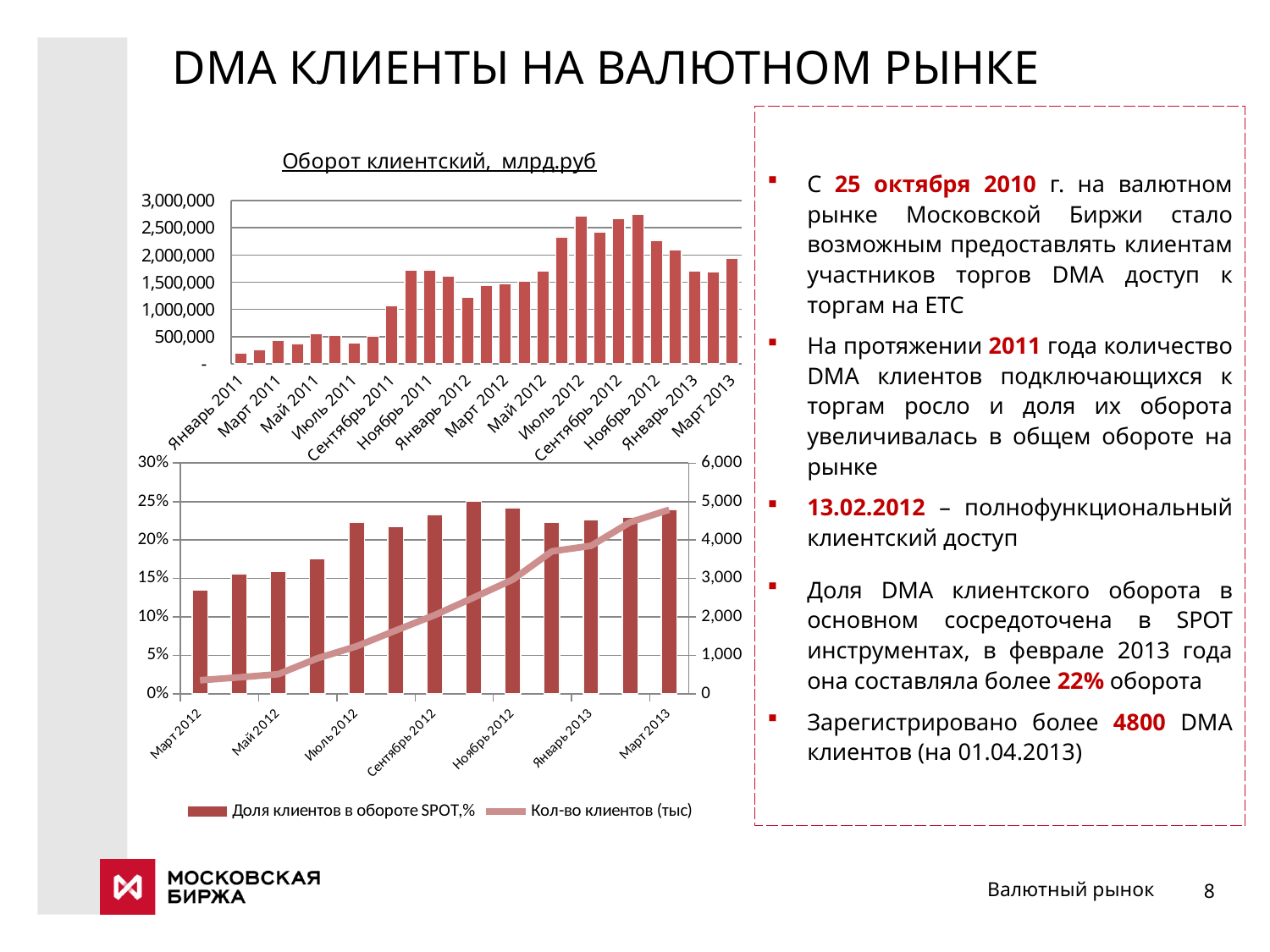
In the bottom chart, is the value of "Доля клиентов в обороте SPOT,%" for Март 2012 greater or less than 15%? less In the bottom chart, is the value of "Кол-во клиентов (тыс)" for Март 2013 greater or less than 4,000? greater In the bottom chart, does the line "Кол-во клиентов (тыс)" rise or fall from Март 2012 to Март 2013? Rises How many series does the legend of the bottom chart list? 2 In the top chart "Оборот клиентский, млрд.руб", is the value for Январь 2011 greater or less than 500,000? less In the top chart "Оборот клиентский, млрд.руб", which is larger: the value for Июль 2012 or the value for Март 2013? Июль 2012 In the top chart "Оборот клиентский, млрд.руб", which month has the lowest value? Январь 2011 How many monthly bars are plotted in the top chart "Оборот клиентский, млрд.руб"? 27 What kind of chart is the top chart titled "Оборот клиентский, млрд.руб"? Bar chart In the bottom chart, which month has the lowest value for "Доля клиентов в обороте SPOT,%"? Март 2012